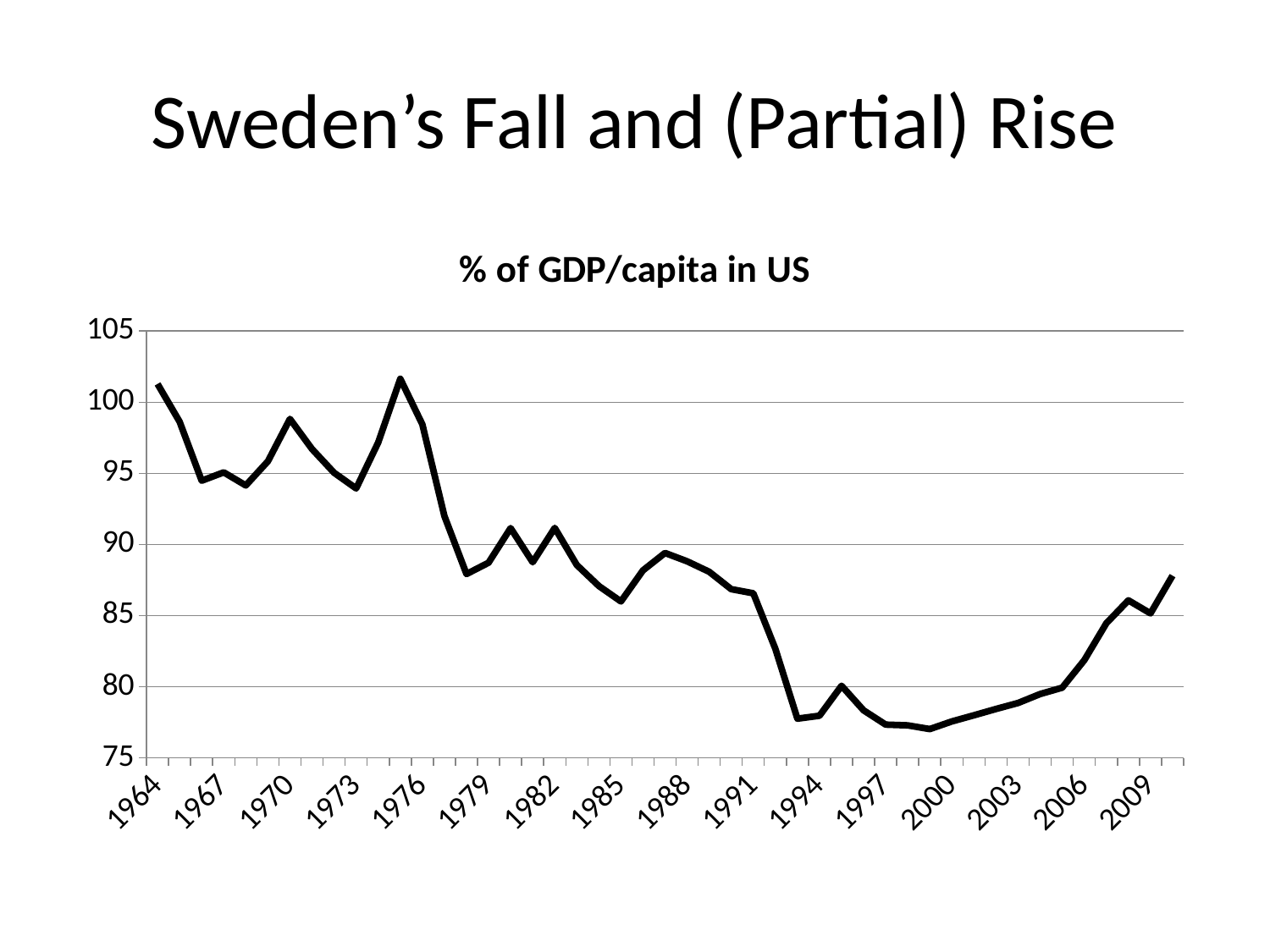
What kind of chart is shown on the slide? line chart What is the title of the chart? % of GDP/capita in US Is the value for 2000 greater or less than 80? less Is the value for 1985 greater or less than 90? less Which is larger, the value for 1976 or the value for 1994? 1976 Which is larger, the value for 1988 or the value for 1997? 1988 Is the value for 1970 greater or less than 95? greater Do the values generally rise or fall from 2000 to 2009? rise Do the values generally rise or fall from 1964 to 1994? fall